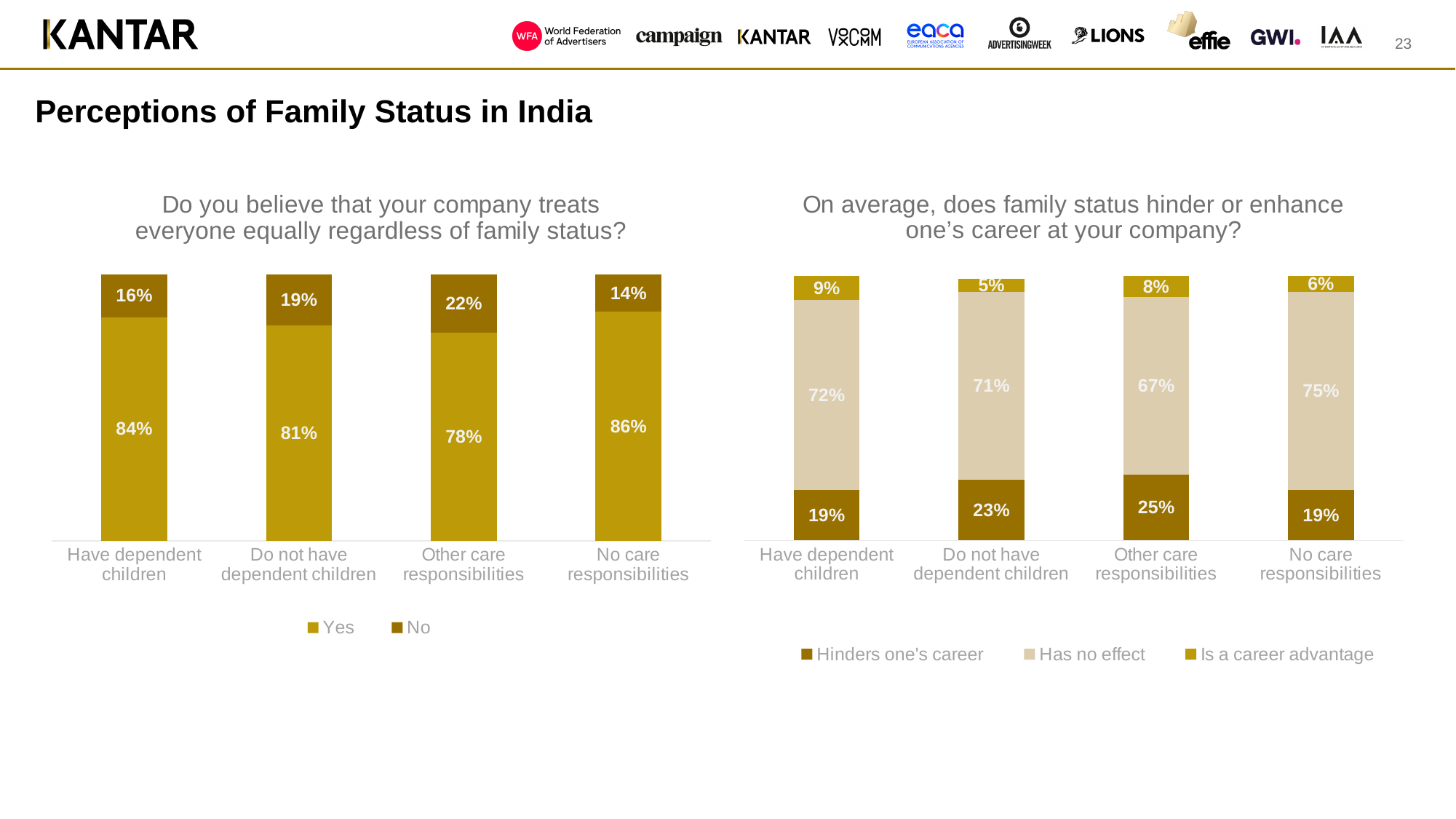
In the right chart, what is the 'Hinders one's career' value for 'Other care responsibilities'? 25% What kind of chart is the right chart? Stacked bar chart In the right chart, how many categories are shown on the x axis? 4 In the left chart, what is the difference between the 'Yes' values for 'No care responsibilities' and 'Do not have dependent children'? 5% In the right chart, is the 'Hinders one's career' value larger for 'Do not have dependent children' or for 'Have dependent children'? Do not have dependent children In the right chart, which category has the highest 'Is a career advantage' value? Have dependent children In the left chart, which category has the lowest 'Yes' value? Other care responsibilities In the left chart, how many series does the legend list? 2 In the left chart ('Do you believe that your company treats everyone equally regardless of family status?'), what is the 'Yes' value for 'Have dependent children'? 84% In the left chart, which category has the highest 'Yes' value? No care responsibilities In the left chart, what is the 'No' value for 'Other care responsibilities'? 22% In the right chart ('On average, does family status hinder or enhance one's career at your company?'), what is the 'Has no effect' value for 'No care responsibilities'? 75%